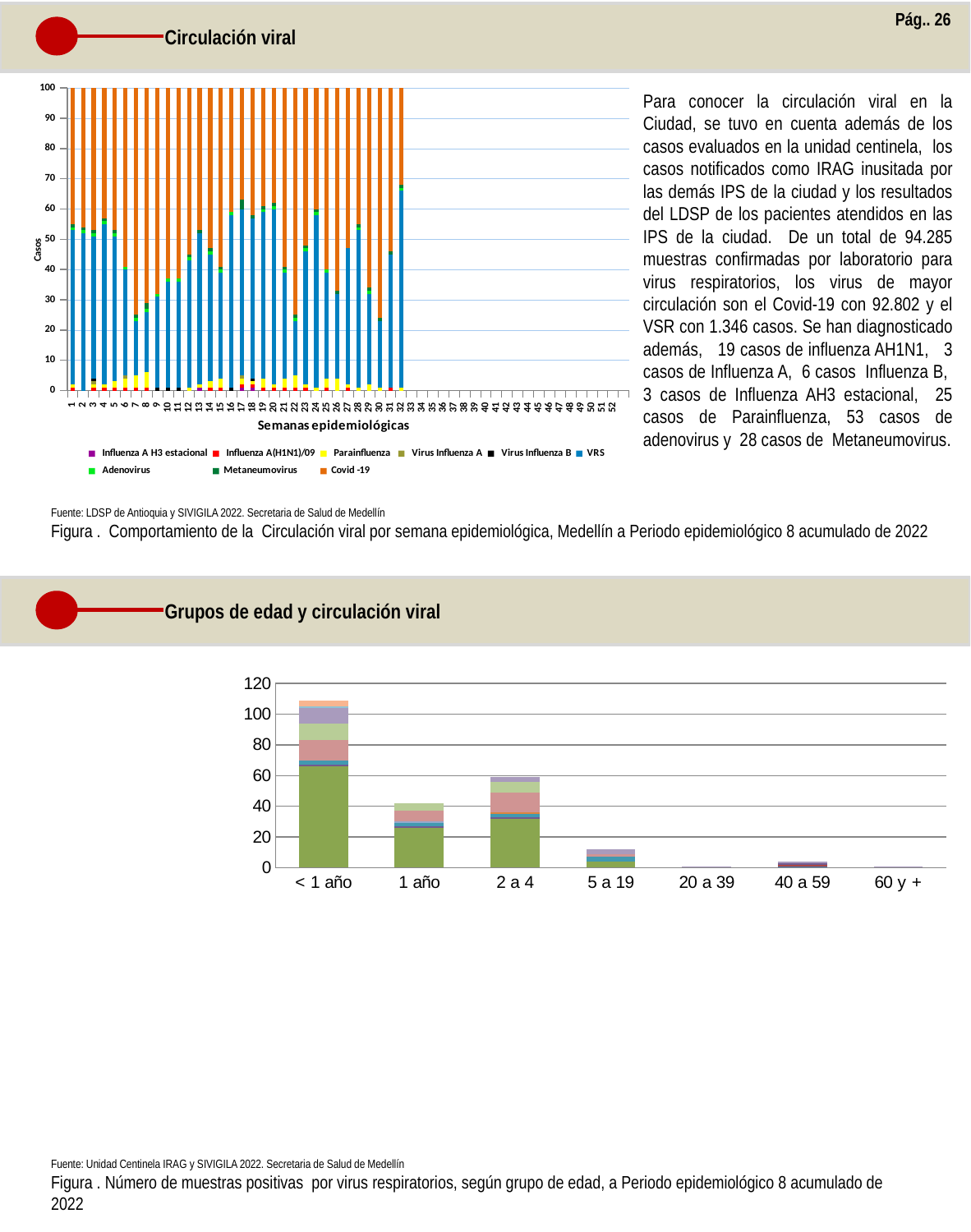
What kind of chart is the bottom chart (Grupos de edad y circulación viral)? Stacked bar chart In the top chart (Circulación viral), how many epidemiological weeks are labelled on the x axis? 52 In the bottom chart (Grupos de edad y circulación viral), which bar is taller: '1 año' or '2 a 4'? 2 a 4 In the bottom chart (Grupos de edad y circulación viral), is the total for '1 año' greater or less than 60? less What kind of chart is the top chart titled 'Circulación viral'? Stacked bar chart In the bottom chart (Grupos de edad y circulación viral), how many age groups are shown on the x axis? 7 In the top chart (Circulación viral), what is the title of the x axis? Semanas epidemiológicas In the top chart (Circulación viral), is the top of the VRS segment in week 7 greater or less than 30? less In the bottom chart (Grupos de edad y circulación viral), which age group has the tallest bar? < 1 año In the top chart (Circulación viral), how many series does the legend list? 9 In the bottom chart (Grupos de edad y circulación viral), is the total for '< 1 año' greater or less than 100? greater In the top chart (Circulación viral), which series is shown in orange in the legend? Covid -19